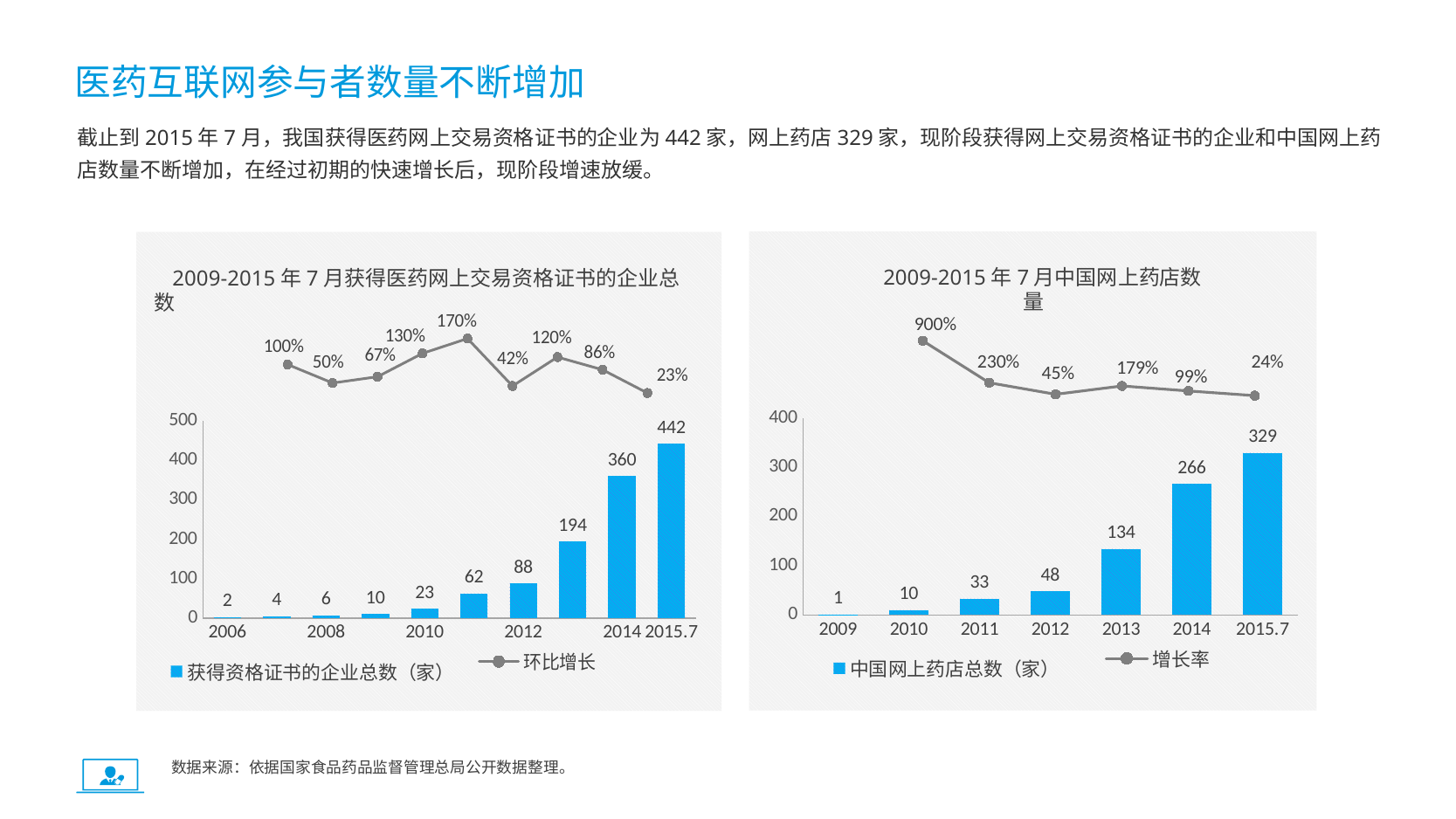
In the left chart, what is the difference between the bar values for 2014 and 2015.7? 82 In the left chart, how many bars are plotted? 10 In the right chart, do the bar values rise or fall from 2009 to 2015.7? rise In the right chart (2009-2015年7月中国网上药店数量), what is the value of the bar for 2013? 134 In the right chart, what is the difference between the bar values for 2014 and 2013? 132 In the left chart, what is the 环比增长 value labelled 170%? Which is the highest 环比增长 value shown? 170% In the right chart, which year has the lowest bar value? 2009 In the right chart, which is larger: the bar value for 2011 or for 2012? 2012 In the right chart, how many series does the legend list? 2 In the left chart (2009-2015年7月获得医药网上交易资格证书的企业总数), what is the value of the bar for 2015.7? 442 In the left chart, what is the value of the bar for 2012? 88 In the right chart, what is the 增长率 value for 2010? 900%